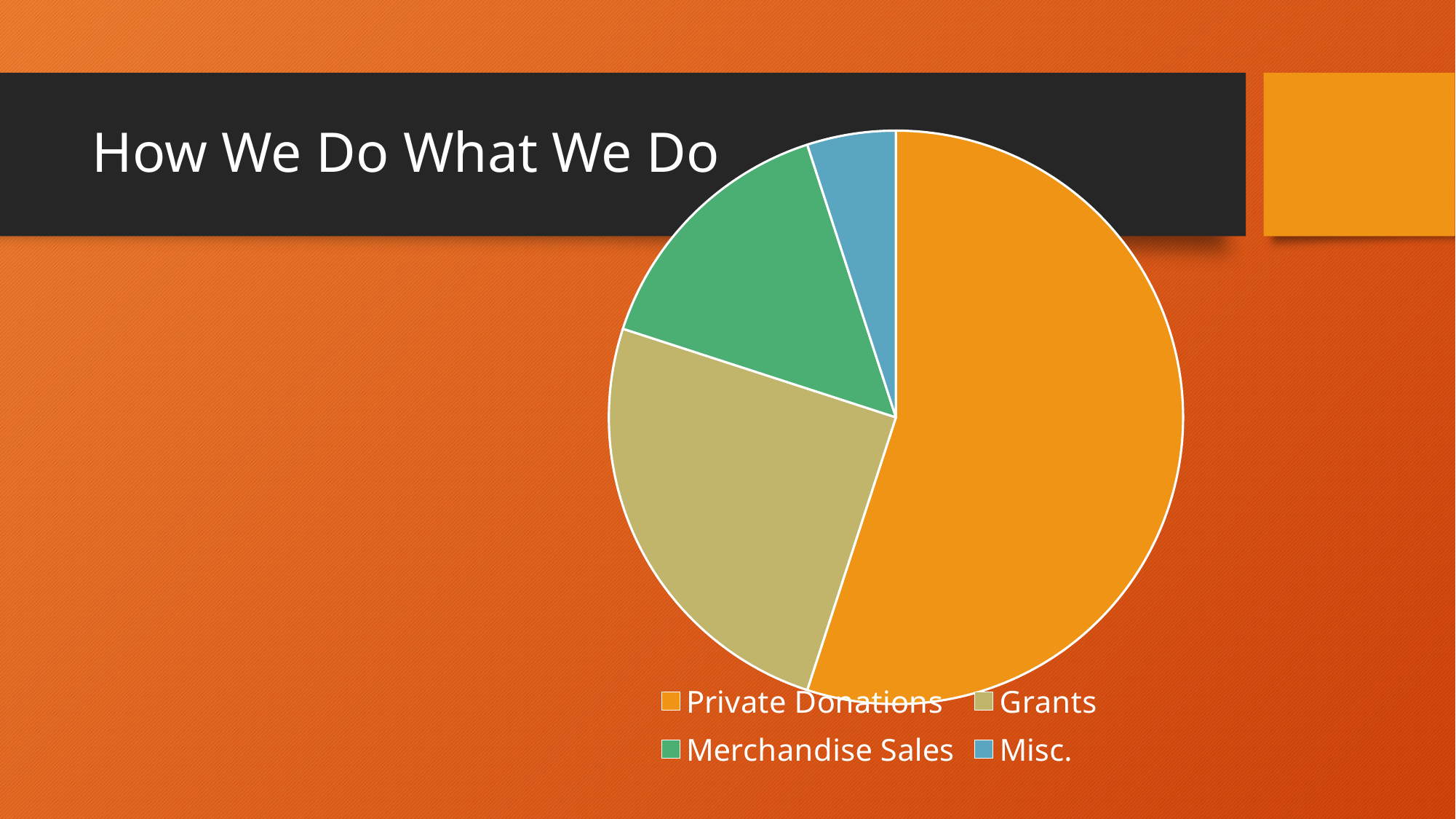
What kind of chart is shown on the slide? pie chart Does the Private Donations slice take up more or less than half of the pie? more Which slice is larger, Misc. or Merchandise Sales? Merchandise Sales Which category is shown in blue in the legend? Misc. Which slice is larger, Grants or Merchandise Sales? Grants What colour is the Merchandise Sales slice? green Which category has the smallest slice of the pie chart? Misc. Which category has the largest slice of the pie chart? Private Donations How many entries does the legend list? 4 How many slices does the pie chart have? 4